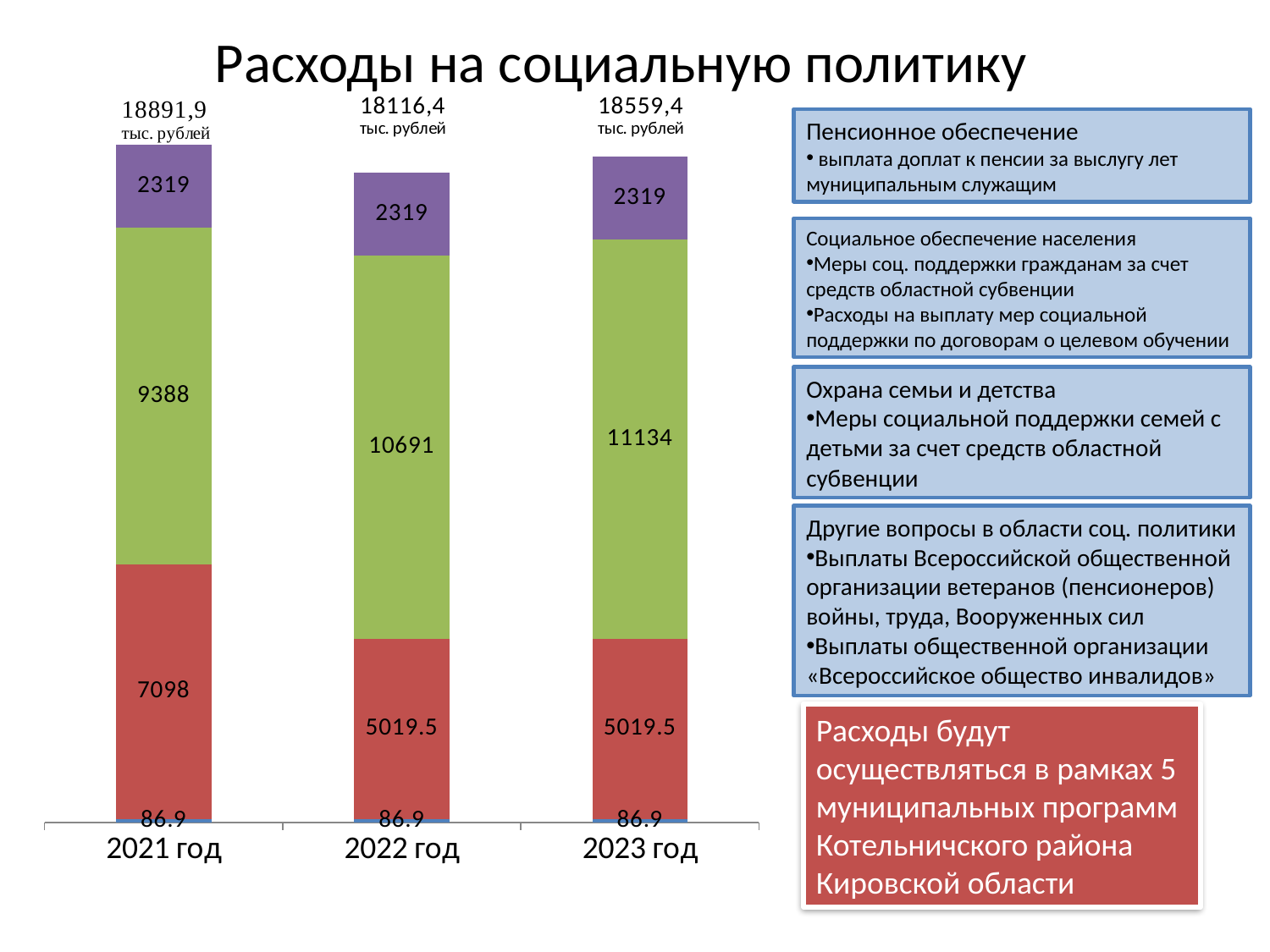
What is the value of the red segment for 2021 год? 7098 What is the total printed above the bar for 2023 год? 18559,4 тыс. рублей What is the difference between the red segment for 2021 год and the red segment for 2022 год? 2078.5 What kind of chart is shown on the slide? stacked bar chart Does the value of the green segment rise or fall from 2021 год to 2023 год? rises Which year has the highest total expenditure? 2021 год For 2021 год, which is larger: the green segment or the red segment? the green segment (9388) What is the title of the slide? Расходы на социальную политику How many bars (years) are shown in the chart? 3 Which year has the lowest total expenditure? 2022 год By how much does the green segment for 2023 год exceed the green segment for 2022 год? 443 What is the value of the green segment for 2022 год? 10691